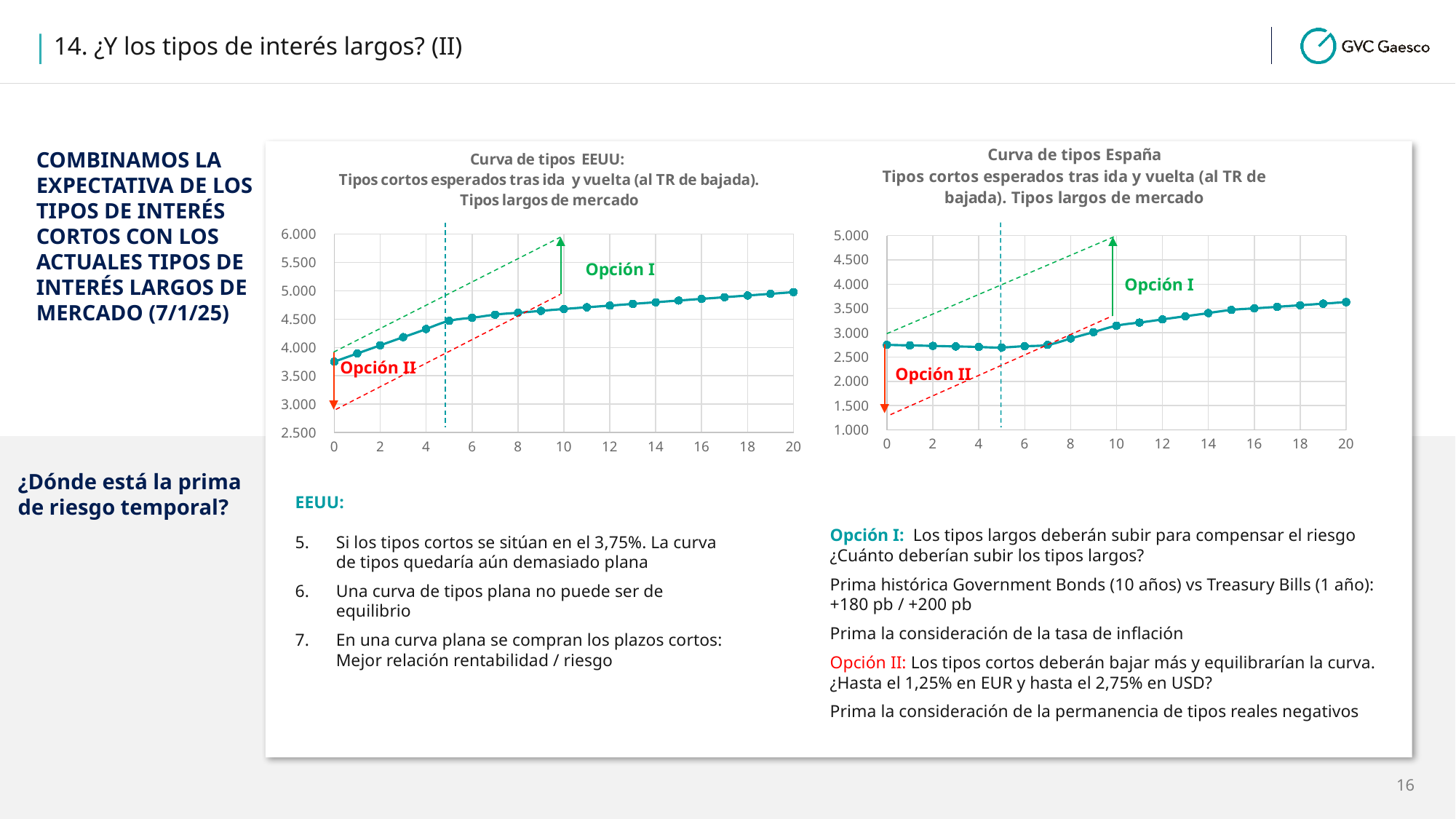
What are the two labelled options annotated with arrows on the 'Curva de tipos EEUU' chart? Opción I and Opción II What kind of chart is the 'Curva de tipos España' chart on the right? line chart What kind of chart is the 'Curva de tipos EEUU' chart on the left? line chart In the 'Curva de tipos España' chart, is the value at x = 0 greater or less than 3.000? less What is the highest value shown on the y axis of the 'Curva de tipos España' chart? 5.000 In the 'Curva de tipos España' chart, which is larger: the value at x = 0 or the value at x = 10? the value at x = 10 In the 'Curva de tipos EEUU' chart, which is larger: the value at x = 0 or the value at x = 20? the value at x = 20 In the 'Curva de tipos EEUU' chart, is the value at x = 10 greater or less than 4.500? greater In the 'Curva de tipos EEUU' chart, is the value at x = 0 greater or less than 4.000? less In the 'Curva de tipos EEUU' chart, do the plotted values rise or fall as the x axis goes from 0 to 20? rise